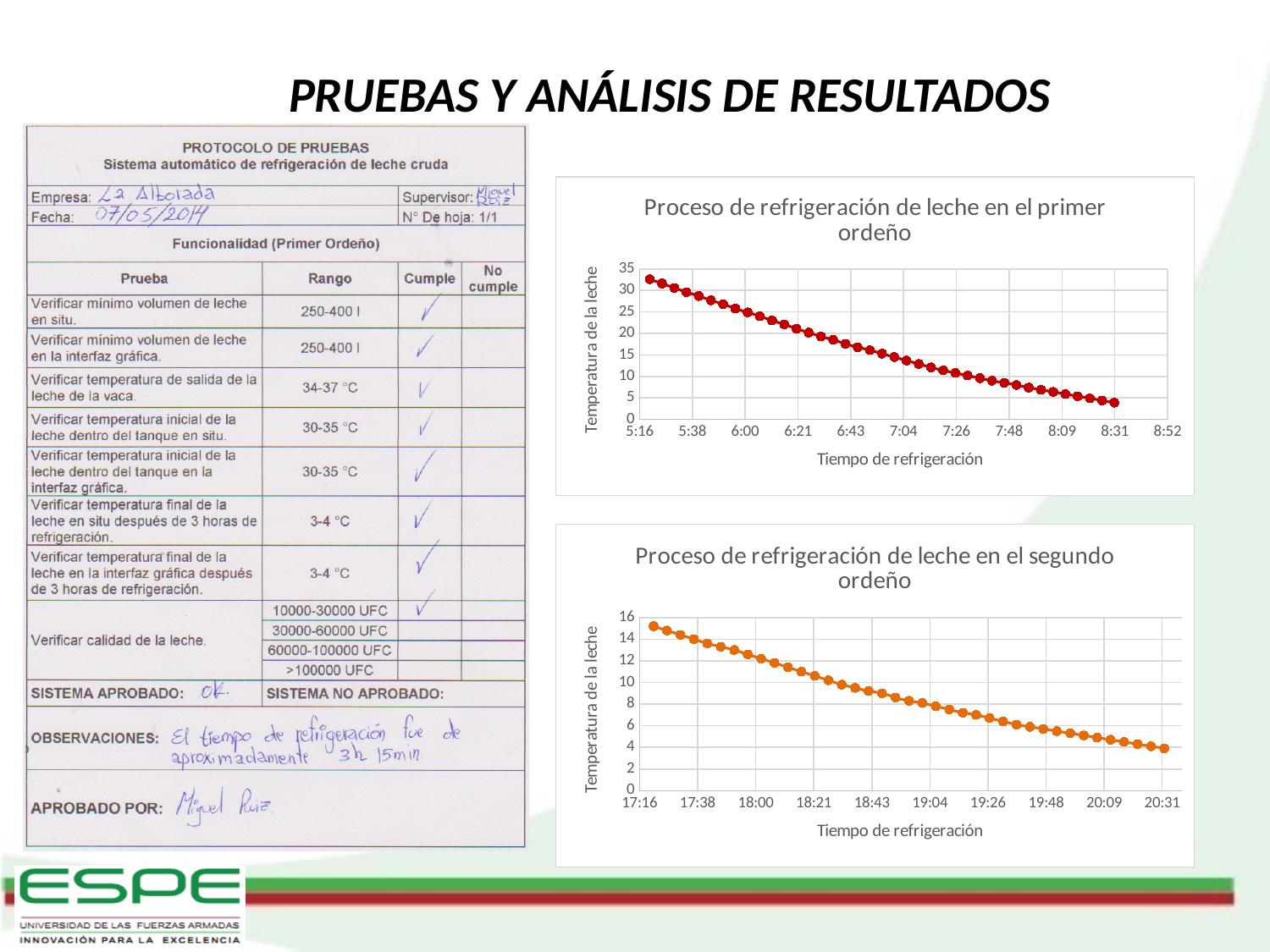
In the bottom chart, 'Proceso de refrigeración de leche en el segundo ordeño', is the temperature at the last plotted point greater or less than 6? less What is the x-axis label of the top chart, 'Proceso de refrigeración de leche en el primer ordeño'? Tiempo de refrigeración In the top chart, 'Proceso de refrigeración de leche en el primer ordeño', do the temperature values rise or fall as time increases along the x axis? fall What is the y-axis label of the bottom chart, 'Proceso de refrigeración de leche en el segundo ordeño'? Temperatura de la leche In the bottom chart, 'Proceso de refrigeración de leche en el segundo ordeño', is the temperature at the first plotted point greater or less than 12? greater What kind of chart is the top chart, 'Proceso de refrigeración de leche en el primer ordeño'? scatter chart In the top chart, 'Proceso de refrigeración de leche en el primer ordeño', is the temperature at the first plotted point greater or less than 25? greater In the top chart, 'Proceso de refrigeración de leche en el primer ordeño', is the temperature higher at 6:00 or at 8:09? 6:00 In the bottom chart, 'Proceso de refrigeración de leche en el segundo ordeño', do the temperature values rise or fall as time increases along the x axis? fall In the bottom chart, 'Proceso de refrigeración de leche en el segundo ordeño', is the temperature higher at 18:00 or at 20:09? 18:00